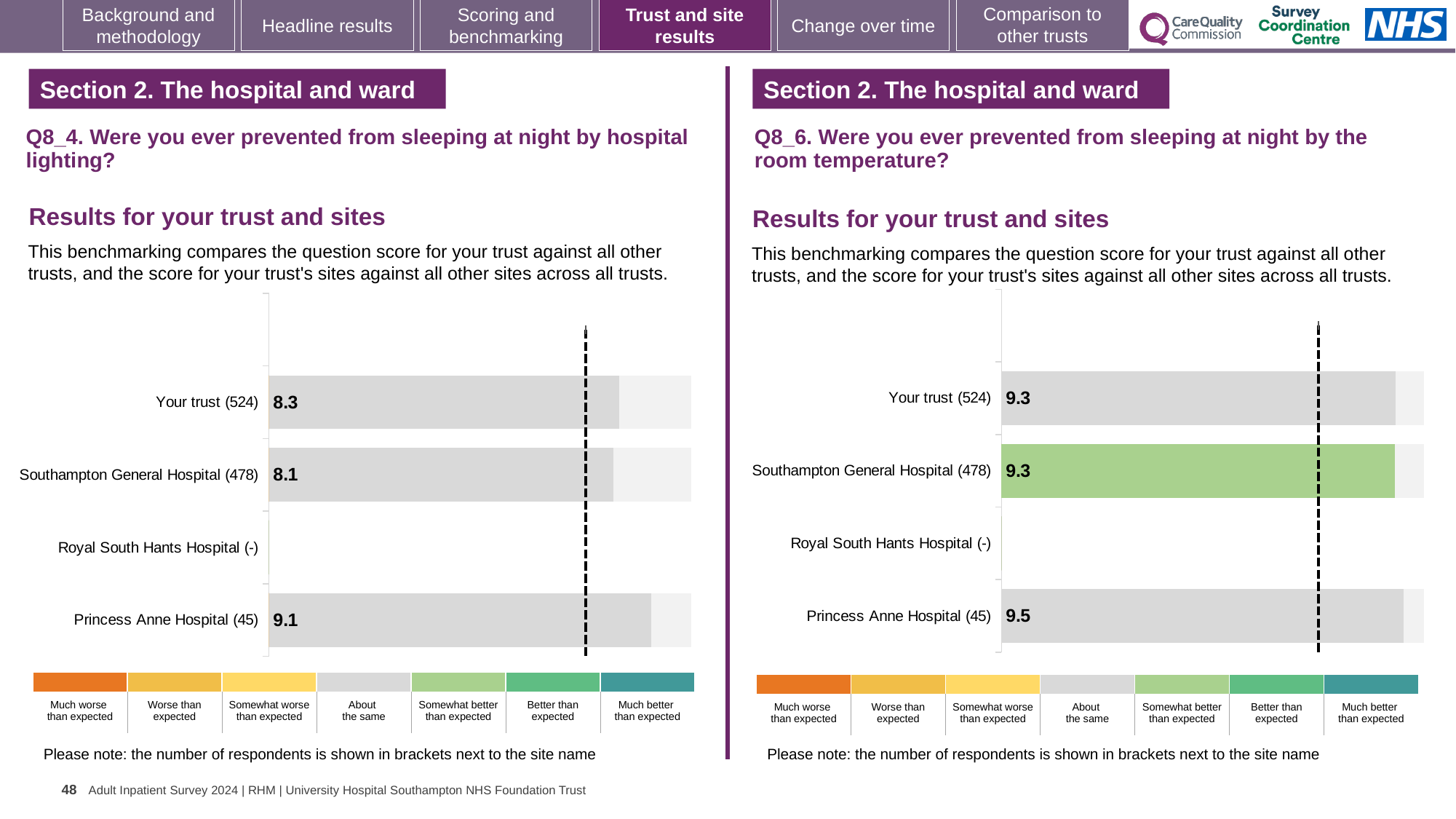
In the Q8_4 hospital lighting chart, what is the score for Southampton General Hospital (478)? 8.1 In the Q8_4 hospital lighting chart, what is the score for Princess Anne Hospital (45)? 9.1 Which is larger: the Your trust score in the Q8_4 hospital lighting chart or the Your trust score in the Q8_6 room temperature chart? Q8_6 room temperature (9.3) In the Q8_6 room temperature chart, what is the difference between the scores for Princess Anne Hospital and Your trust? 0.2 In the Q8_4 hospital lighting chart, what is the score for Your trust (524)? 8.3 In the Q8_6 room temperature chart, what is the score for Princess Anne Hospital (45)? 9.5 In the Q8_6 room temperature chart, what is the score for Southampton General Hospital (478)? 9.3 In the Q8_4 hospital lighting chart, which site has the highest score? Princess Anne Hospital (45) What type of chart is used for the Q8_6 room temperature results? Bar chart How many site rows are listed in the Q8_4 hospital lighting chart? 4 In the Q8_4 hospital lighting chart, what is the difference between the scores for Princess Anne Hospital and Southampton General Hospital? 1.0 In the Q8_6 room temperature chart, what is the score for Your trust (524)? 9.3